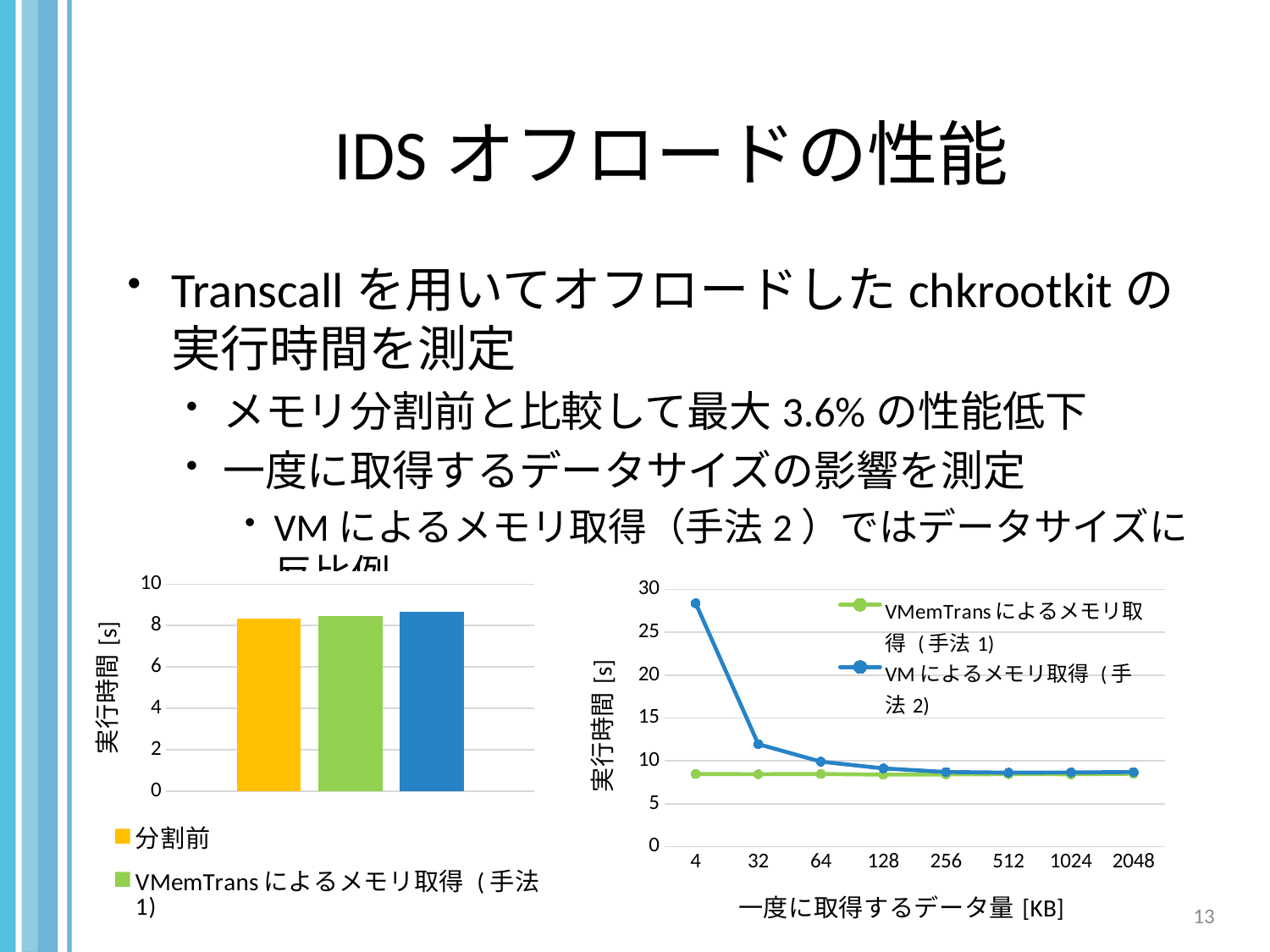
In the chart on the right, how many series does the legend list? 2 In the chart on the right, at 4 KB, which series has the higher execution time: VMemTrans によるメモリ取得（手法 1）or VM によるメモリ取得（手法 2）? VM によるメモリ取得（手法 2） In the chart on the right, is the value for VM によるメモリ取得（手法 2）at 32 KB greater or less than 15? less In the chart on the right, how many data points are shown along the x axis for each series? 8 In the chart on the left, is the value for 分割前 greater or less than 6? greater What kind of chart is the chart on the right of the slide? line chart In the chart on the right, does the VM によるメモリ取得（手法 2）series rise or fall as the data size increases along the x axis? fall What is the y-axis title of the chart on the left? 実行時間 [s] What kind of chart is the chart on the left of the slide? bar chart In the chart on the left, how many bars are plotted? 3 What is the x-axis title of the chart on the right? 一度に取得するデータ量 [KB] In the chart on the right, is the value for VM によるメモリ取得（手法 2）at 4 KB greater or less than 20? greater